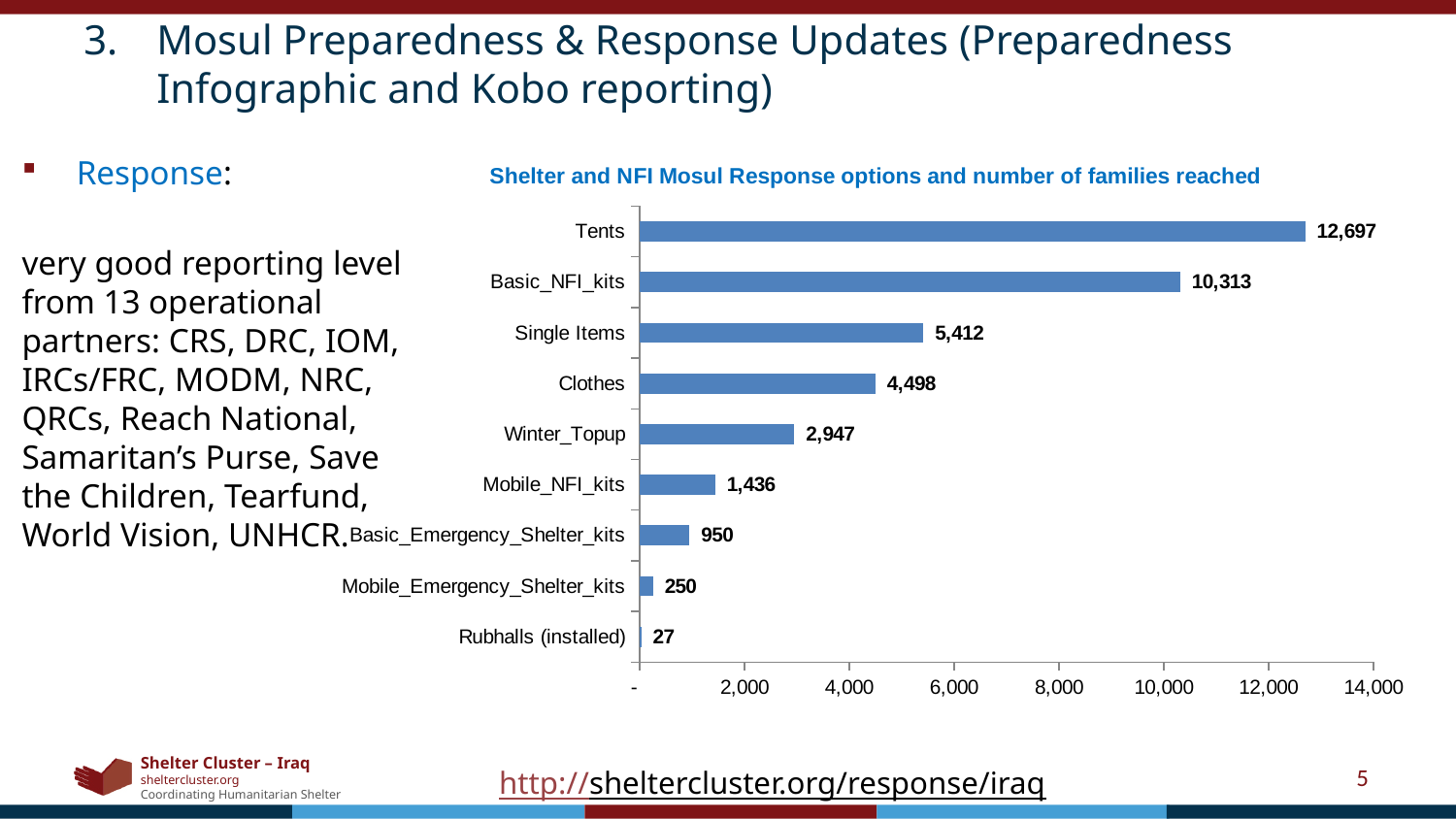
How many response options are shown in the chart? 9 What is the difference between the values for Tents and Basic_NFI_kits? 2,384 What is the number of families reached with Tents? 12,697 How many families were reached with Basic_NFI_kits? 10,313 What is the title of the chart? Shelter and NFI Mosul Response options and number of families reached What is the difference between Single Items and Clothes? 914 What value is shown for Winter_Topup? 2,947 What type of chart is shown on the slide? Bar chart What is the value for Rubhalls (installed)? 27 Which response option has the lowest value? Rubhalls (installed) Which response option reached the most families? Tents Which is larger, Mobile_NFI_kits or Basic_Emergency_Shelter_kits? Mobile_NFI_kits